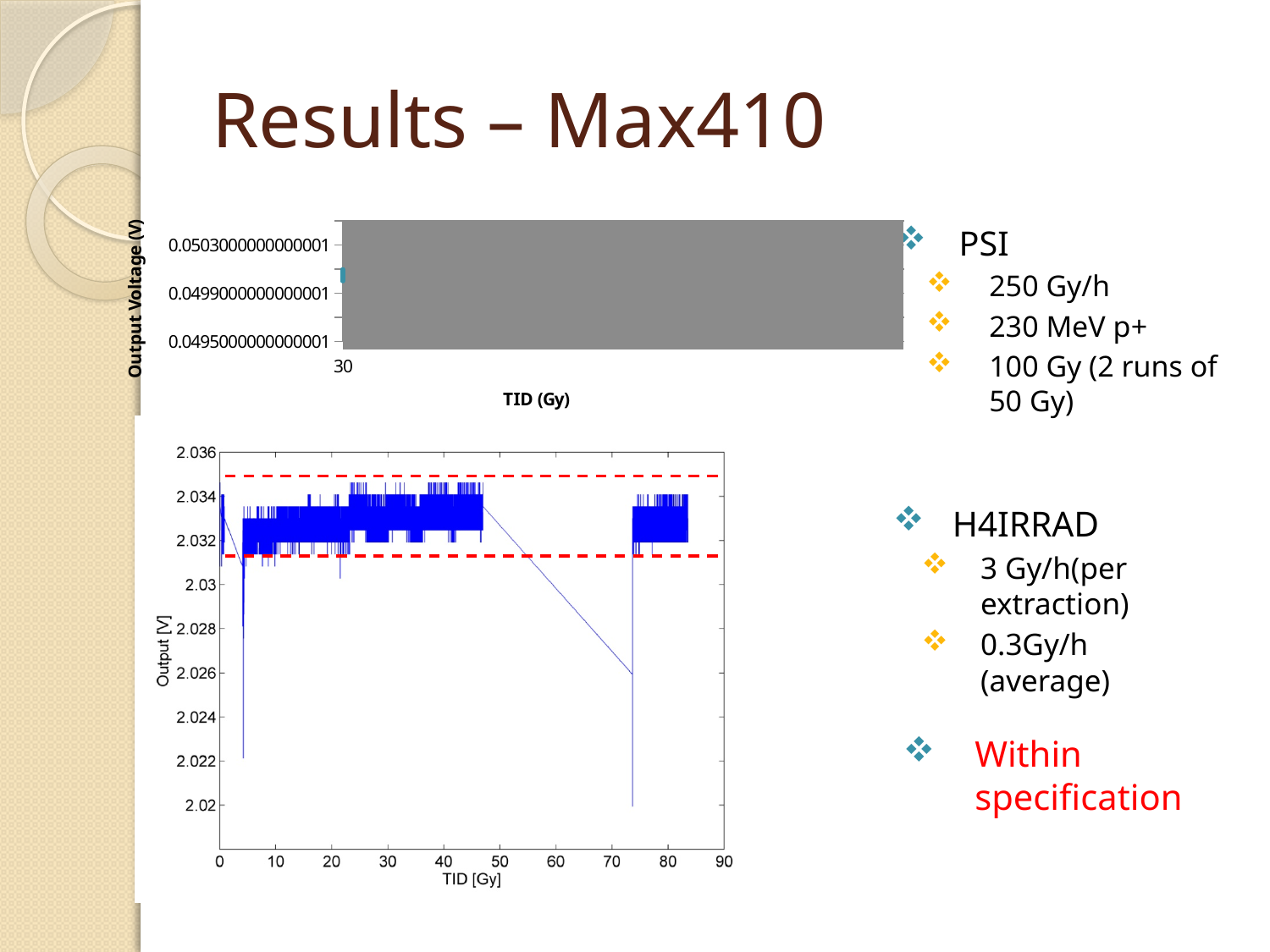
What kind of chart is the bottom chart on the slide? line chart In the bottom chart, what is the highest value shown on the x axis? 90 In the top chart, what is the title of the y axis? Output Voltage (V) In the bottom chart, what colour are the two dashed horizontal limit lines? red In the bottom chart, is the lowest point of the blue line (near TID 74) greater or less than 2.022? less In the bottom chart, is the output value at TID 30 greater or less than 2.03? greater In the bottom chart, is the output value at TID 80 greater or less than 2.028? greater In the bottom chart, does the blue line between TID 47 and TID 73 rise or fall as TID increases? fall